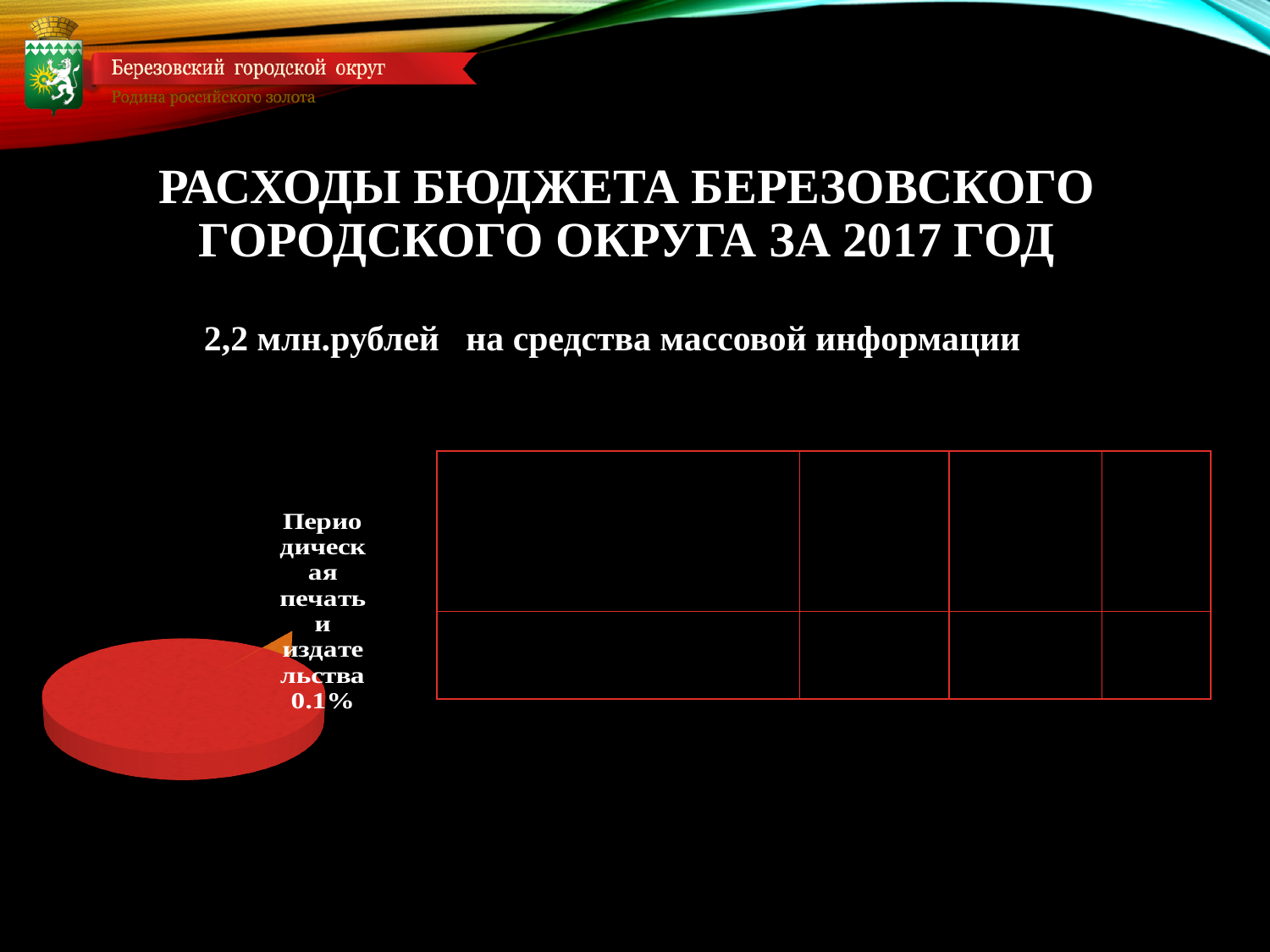
Is the pie chart drawn in 3D or flat 2D? 3D Which slice of the pie chart is larger, the red slice or the small orange slice? the red slice What share of the pie does the slice labelled "Периодическая печать и издательства" represent? 0.1% Which labelled slice of the pie chart is the smallest? Периодическая печать и издательства What kind of chart is shown on the slide? pie chart What colour is the slice labelled "Периодическая печать и издательства" in the pie chart? orange How many slices are visible in the pie chart? 2 What percentage is printed next to the label "Периодическая печать и издательства" on the pie chart? 0.1%